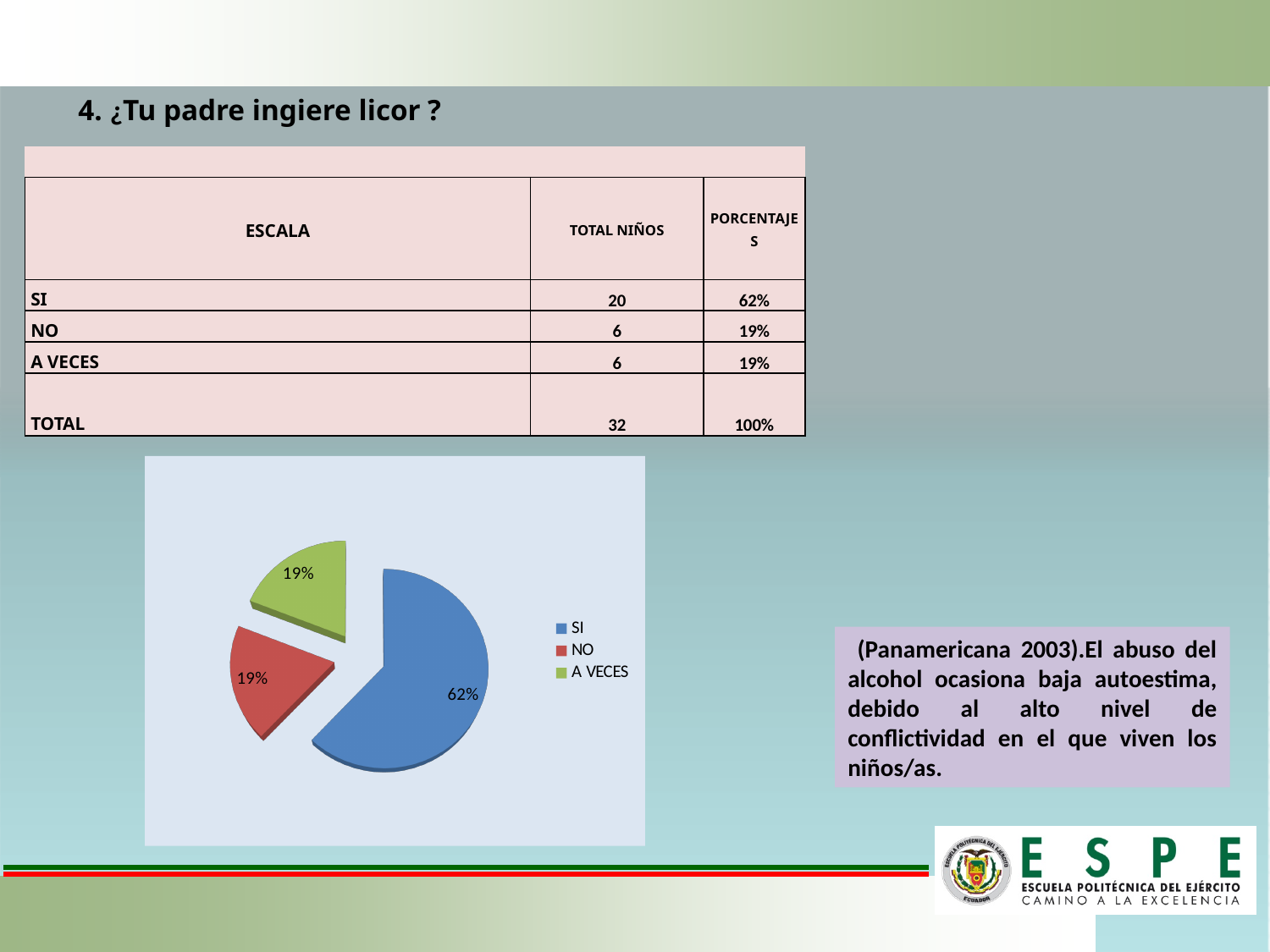
What percentage does the A VECES slice of the pie chart show? 19% What percentage does the NO slice of the pie chart show? 19% How many slices does the pie chart have? 3 Which category has the largest slice in the pie chart? SI What colour is the SI slice in the pie chart? blue What percentage does the SI slice of the pie chart show? 62% Which is larger in the pie chart, the SI slice or the NO slice? SI Is the SI slice of the pie chart greater or less than 50%? greater Which legend entry is shown in green in the pie chart? A VECES What is the difference in percentage points between the SI slice and the A VECES slice? 43 How many entries does the pie chart's legend list? 3 What kind of chart is shown on the slide? pie chart